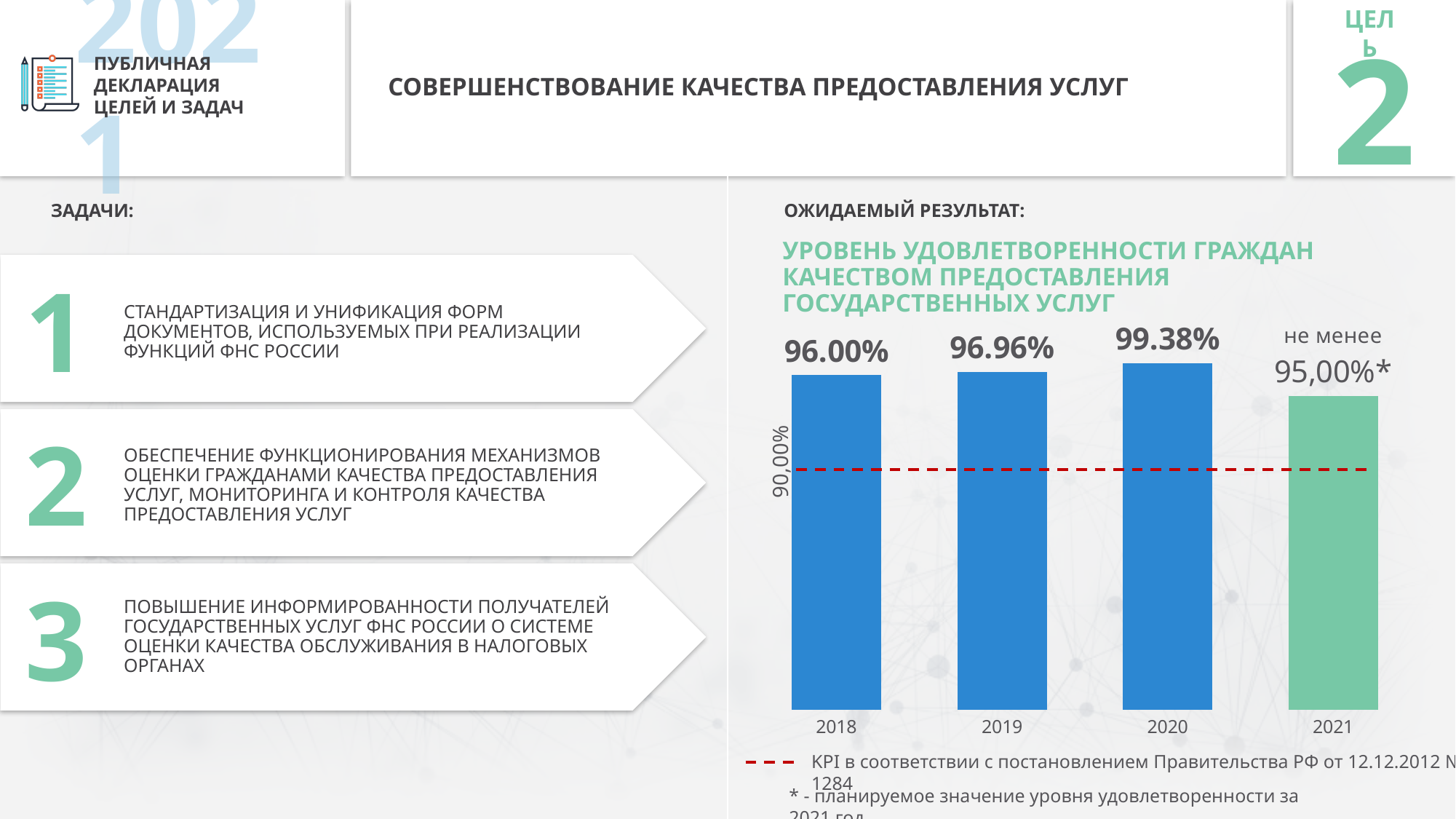
Which year has the lowest bar in the chart? 2021 What kind of chart is shown on the slide? bar chart How many bars are shown in the chart? 4 Which is larger, the value for 2018 or the value for 2020? 2020 What planned value is shown for 2021 in the chart? не менее 95,00%* What is the difference between the values for 2019 and 2018? 0.96% What is the value shown for 2018 in the chart? 96.00% Which year has the highest value in the chart? 2020 Do the values rise or fall from 2018 to 2020? rise What is the value shown for 2020 in the chart? 99.38% What is the value shown for 2019 in the chart? 96.96% What is the difference between the values for 2020 and 2019? 2.42%